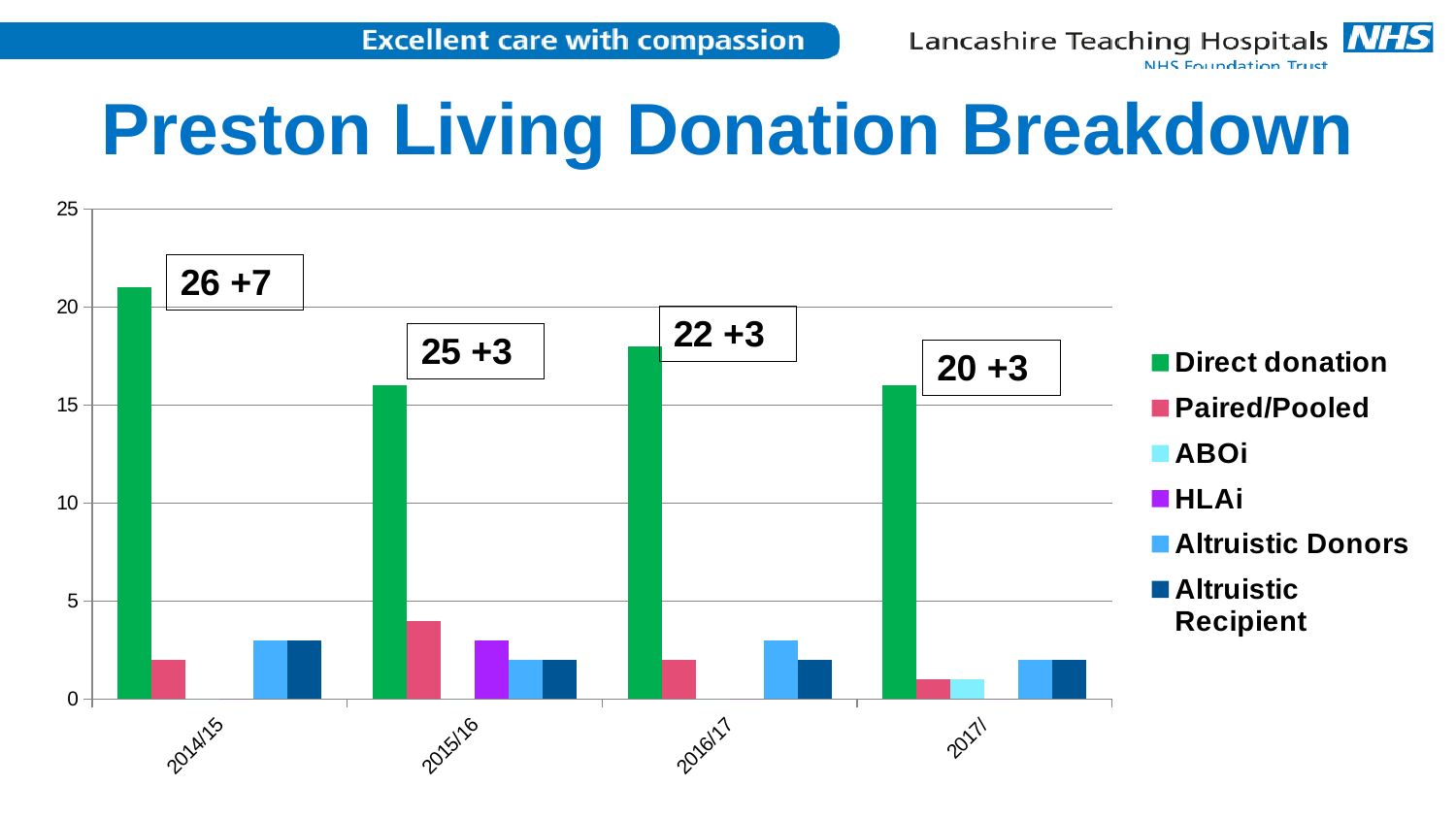
Which is larger, the Paired/Pooled value for 2014/15 or for 2015/16? 2015/16 How many year categories are shown on the x axis of the chart? 4 Is the Paired/Pooled value for 2015/16 greater or less than 5? less Which is larger in 2015/16, the HLAi bar or the Altruistic Donors bar? HLAi What annotation is shown in the box above the 2014/15 group of bars? 26 +7 In which year is the Direct donation bar the highest? 2014/15 Is the Direct donation value for 2016/17 greater or less than 20? less Which series has the tallest bar in every year group? Direct donation How many series does the chart legend list? 6 Is the Direct donation value for 2014/15 greater or less than 20? greater Which is larger, the Direct donation value for 2014/15 or for 2016/17? 2014/15 What kind of chart is shown on the slide? Bar chart